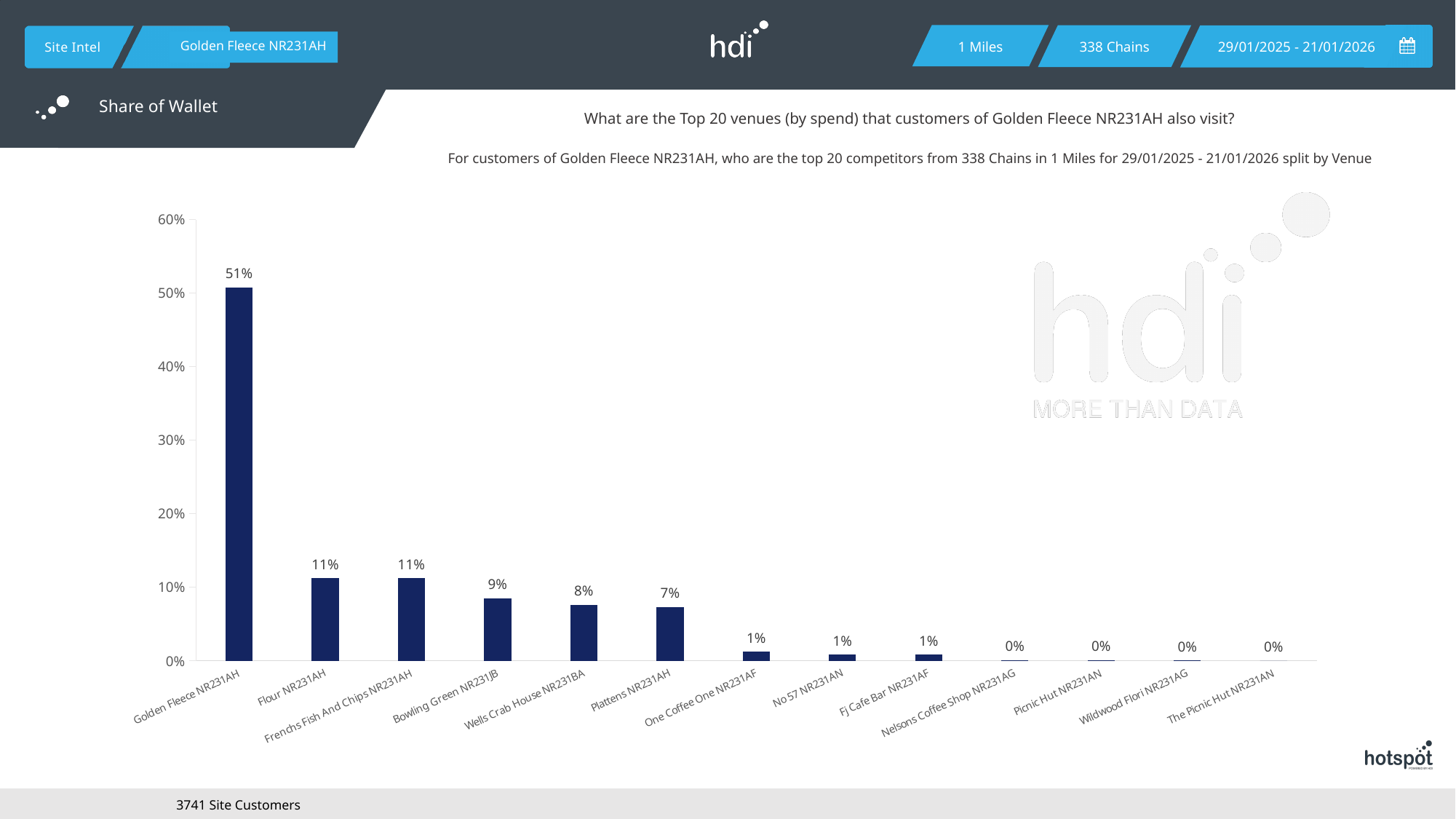
Is the value for Golden Fleece NR231AH greater or less than 40%? greater What is the value for Plattens NR231AH? 7% Which is larger, the value for Bowling Green NR231JB or the value for Plattens NR231AH? Bowling Green NR231JB What is the value for Bowling Green NR231JB? 9% Which venue has the highest value? Golden Fleece NR231AH What is the value for Golden Fleece NR231AH? 51% Do the values generally rise or fall from left to right along the x axis? fall What is the difference between the values for Golden Fleece NR231AH and Flour NR231AH? 40% What kind of chart is shown? bar chart How many venues are shown on the x axis? 13 What is the value for Nelsons Coffee Shop NR231AG? 0% What is the value for Wells Crab House NR231BA? 8%